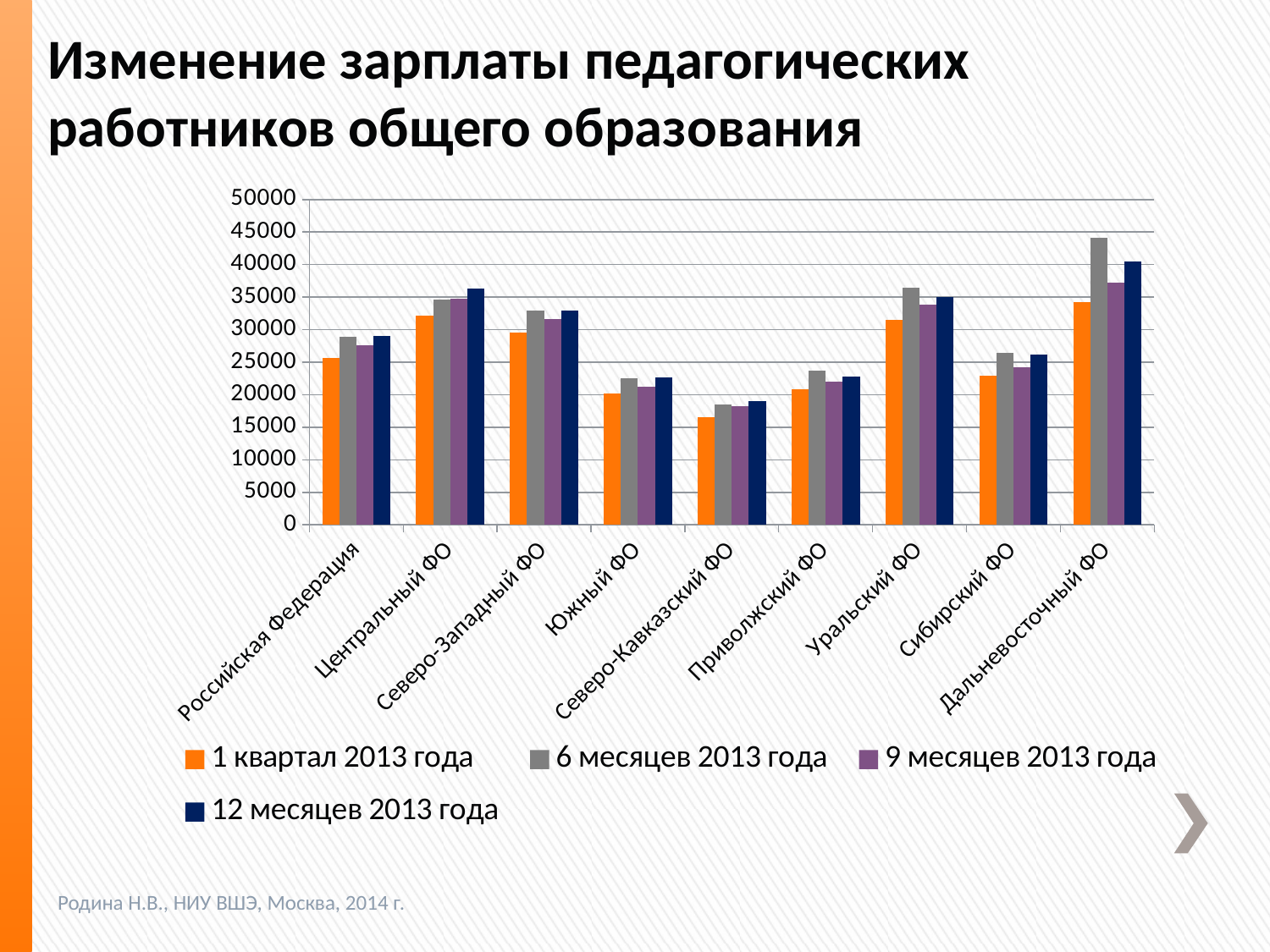
What kind of chart is shown on the slide? bar chart Is the value for Российская Федерация in the series '12 месяцев 2013 года' greater or less than 35000? less Is the value for Дальневосточный ФО in the series '6 месяцев 2013 года' greater or less than 40000? greater Which region has the lowest bar for the series '1 квартал 2013 года'? Северо-Кавказский ФО For the series '12 месяцев 2013 года', which is larger: Дальневосточный ФО or Уральский ФО? Дальневосточный ФО Is the value for Северо-Кавказский ФО in the series '1 квартал 2013 года' greater or less than 20000? less How many categories (regions) are shown on the x axis? 9 What colour represents the series '1 квартал 2013 года' in the legend? orange How many series does the legend list? 4 Which region has the highest bar for the series '6 месяцев 2013 года'? Дальневосточный ФО For the series '1 квартал 2013 года', which is larger: Южный ФО or Северо-Кавказский ФО? Южный ФО